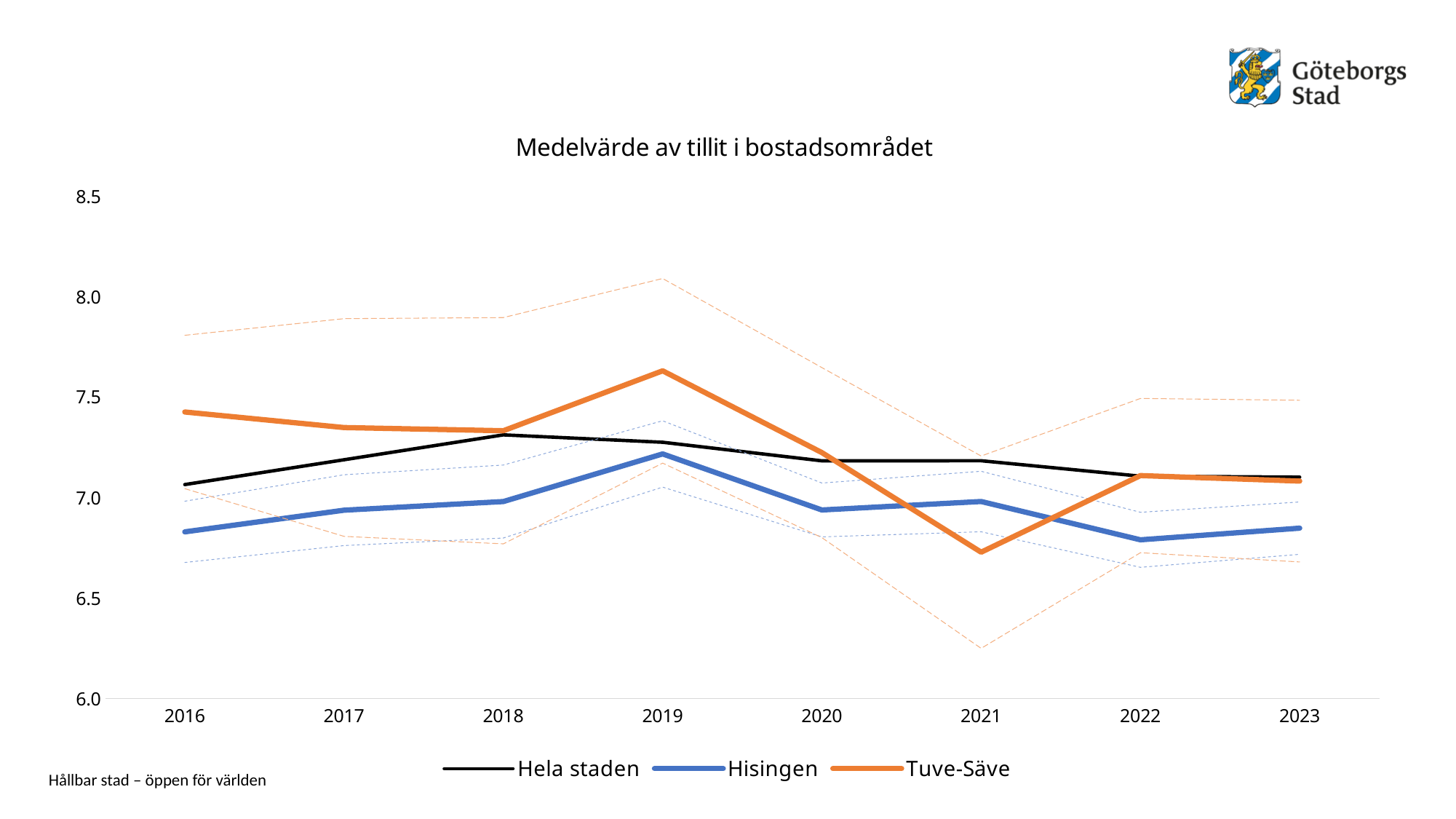
What is the title of the chart? Medelvärde av tillit i bostadsområdet In 2021, which is larger: the value for Hisingen or the value for Tuve-Säve? Hisingen Is the value for Tuve-Säve in 2019 greater or less than 7.5? greater How many series does the legend list? 3 In which year does the Hisingen line reach its highest value? 2019 Is the value for Hisingen in 2016 greater or less than 7.0? less Does the Hela staden line rise or fall from 2018 to 2023? fall Is the value for Tuve-Säve in 2021 greater or less than 7.0? less In which year does the Tuve-Säve line reach its lowest value? 2021 What kind of chart is shown on the slide? line chart In which year does the Tuve-Säve line reach its highest value? 2019 How many years are shown on the x axis? 8